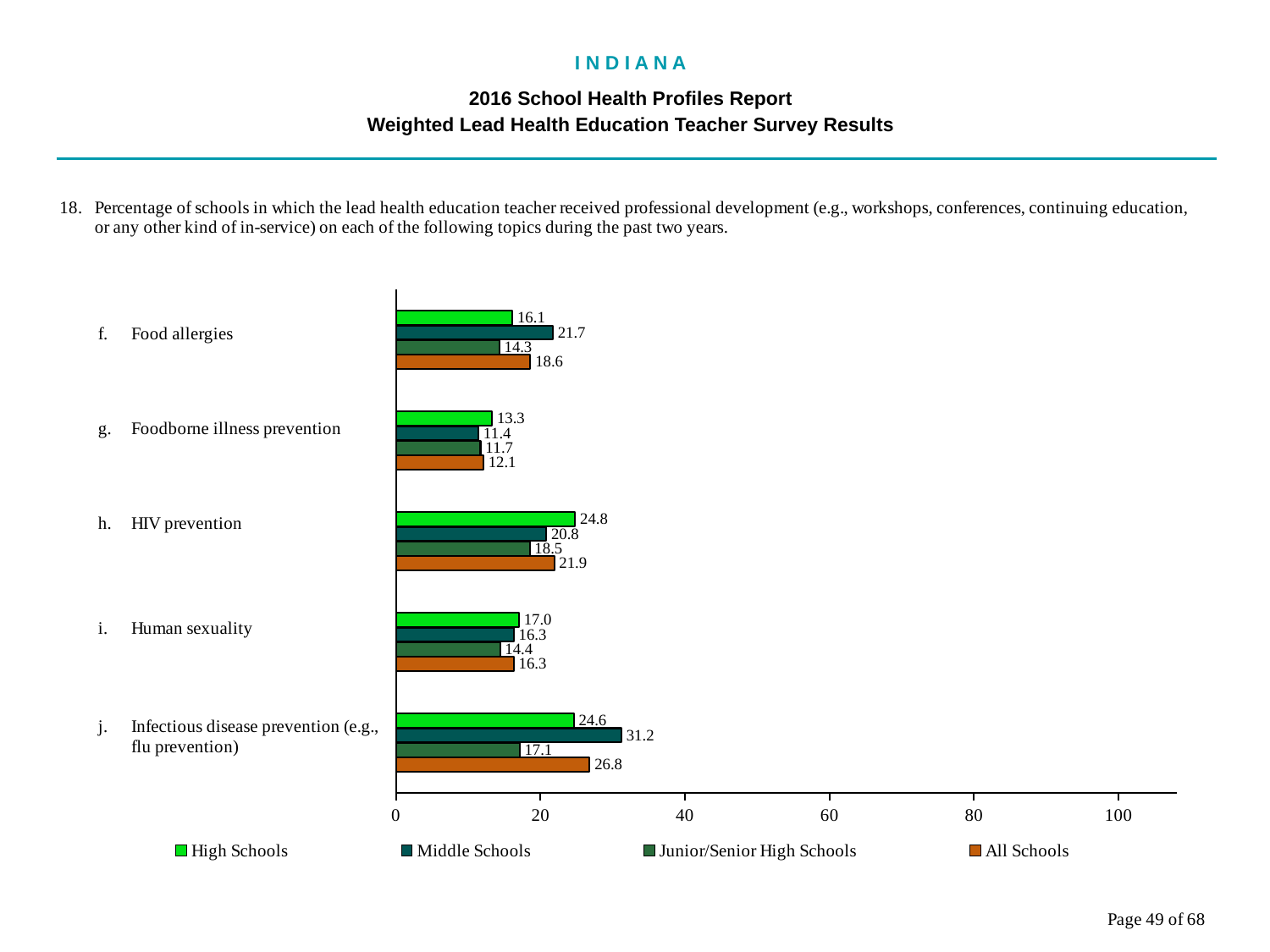
Which topic has the highest value for All Schools? Infectious disease prevention (e.g., flu prevention) What is the difference between the Middle Schools and Junior/Senior High Schools values for Infectious disease prevention (e.g., flu prevention)? 14.1 Is the value for Middle Schools for Infectious disease prevention (e.g., flu prevention) greater or less than 40? less What is the value for High Schools for Foodborne illness prevention? 13.3 What is the value for Middle Schools for Infectious disease prevention (e.g., flu prevention)? 31.2 Which is larger for Food allergies: the High Schools value or the Middle Schools value? Middle Schools How many series does the legend list? 4 What kind of chart is shown on the slide? Bar chart Which topic has the lowest value for High Schools? Foodborne illness prevention How many topics are shown on the chart? 5 What is the value for All Schools for HIV prevention? 21.9 What is the value for Junior/Senior High Schools for Food allergies? 14.3